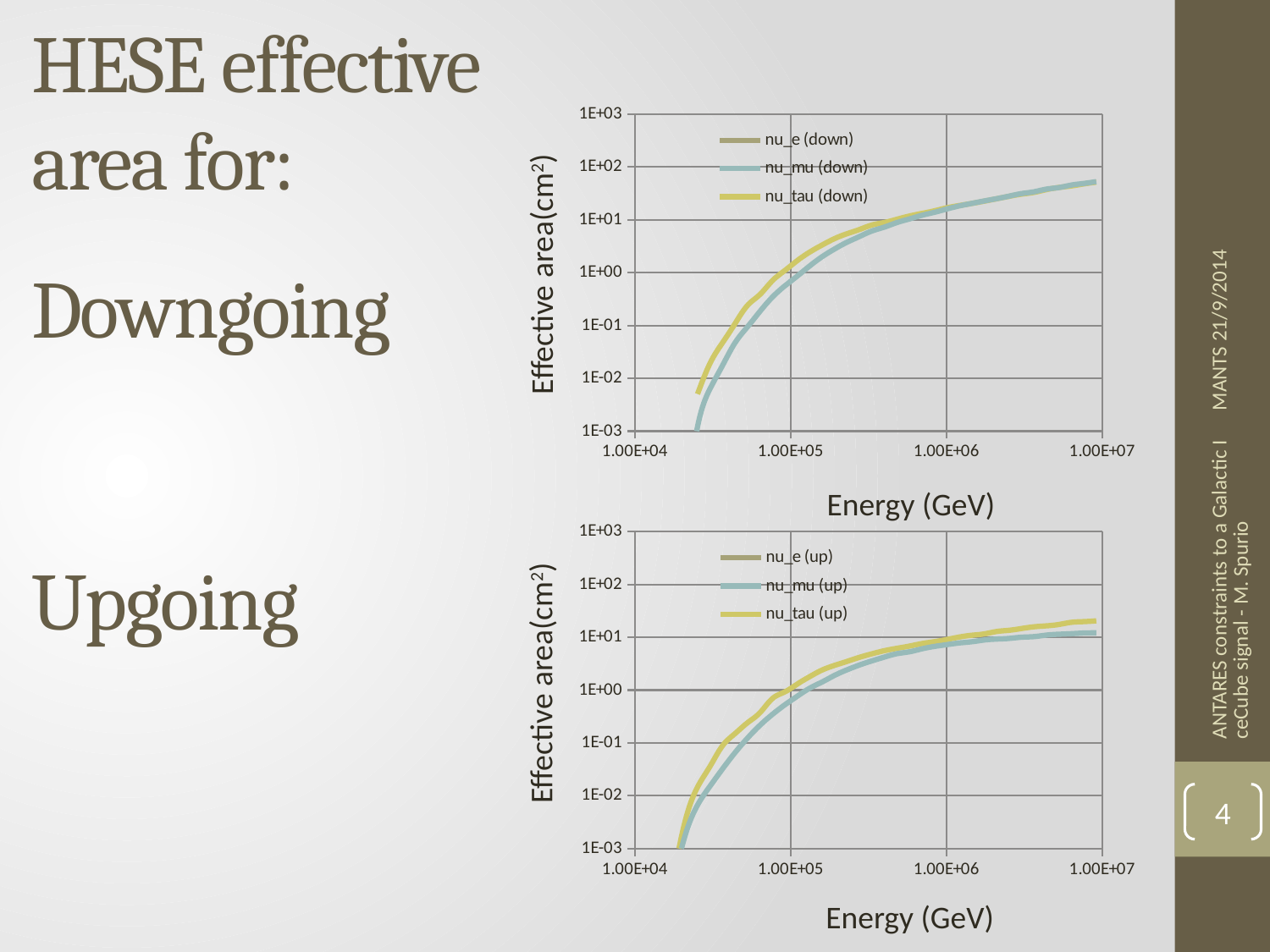
How many series does the legend of the top chart (downgoing) list? 3 How many series does the legend of the bottom chart (upgoing) list? 3 In the bottom chart (upgoing), at 1.00E+07 GeV, which series is higher: nu_tau (up) or nu_mu (up)? nu_tau (up) In the top chart (downgoing), do the effective area values rise or fall as energy increases? rise In the bottom chart (upgoing), do the effective area values rise or fall as energy increases? rise What is the y-axis title of the bottom chart (upgoing)? Effective area(cm2) What kind of chart is the top chart (downgoing)? line chart In the bottom chart (upgoing), at 1.00E+07 GeV, is the effective area for nu_tau (up) greater or less than 1E+01? greater In the top chart (downgoing), at 1.00E+05 GeV, is the effective area for nu_mu (down) greater or less than 1E+01? less In the top chart (downgoing), at 1.00E+07 GeV, is the effective area for nu_tau (down) greater or less than 1E+01? greater What kind of chart is the bottom chart (upgoing)? line chart What is the x-axis title of the top chart (downgoing)? Energy (GeV)